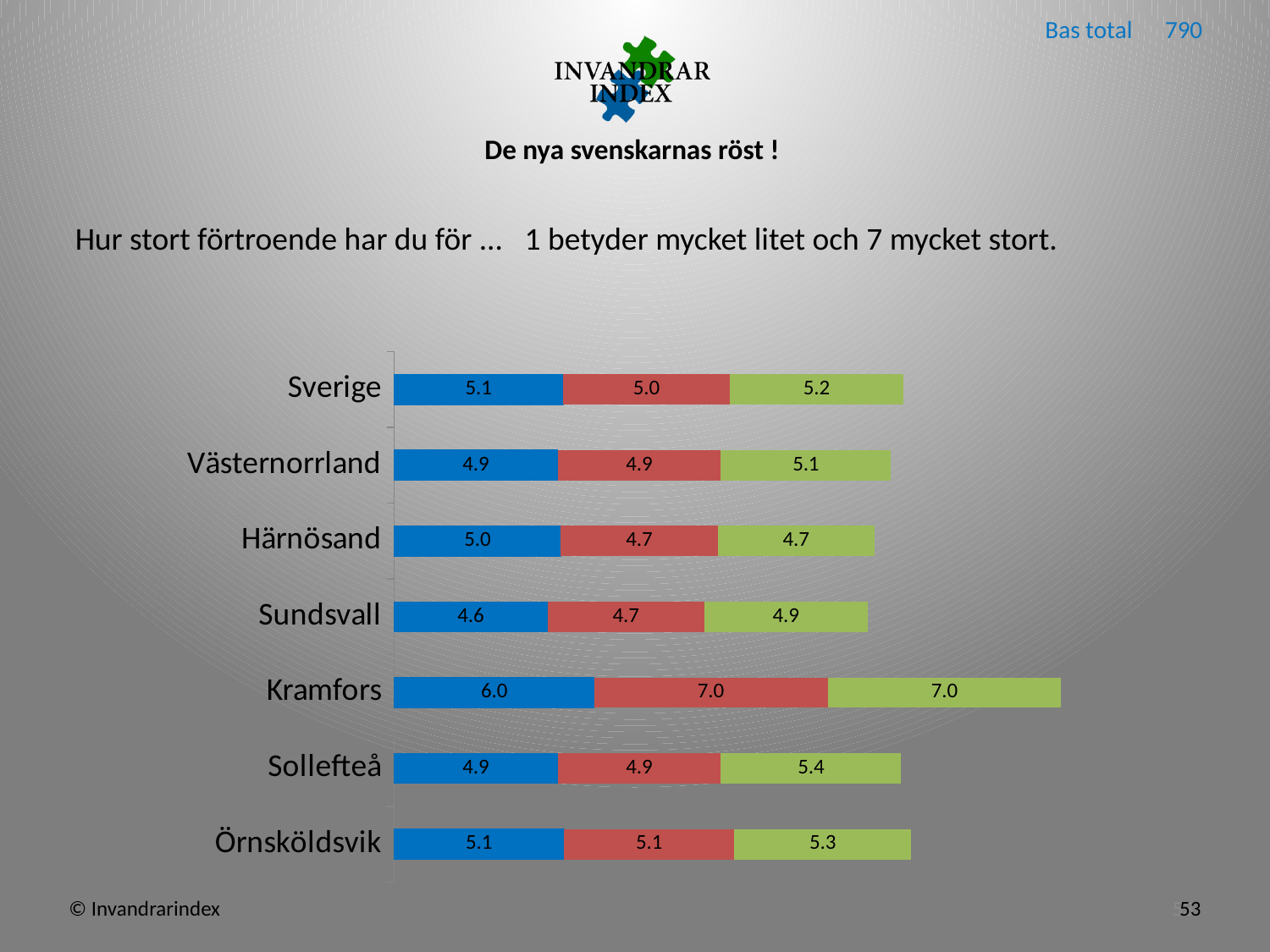
Which has the larger green segment value, Örnsköldsvik or Härnösand? Örnsköldsvik What is the value of the blue segment for Kramfors? 6.0 What kind of chart is shown on the slide? Stacked horizontal bar chart Which category has the highest value in the blue segment? Kramfors What is the total of the stacked bar for Kramfors? 20.0 What is the total of the stacked bar for Sverige? 15.3 How many categories (regions) are shown on the chart? 7 Which category has the lowest value in the blue segment? Sundsvall How many coloured segments does each stacked bar contain? 3 What is the value of the green segment for Sollefteå? 5.4 What is the difference between the green segment values for Kramfors and Sverige? 1.8 What is the value of the red segment for Härnösand? 4.7